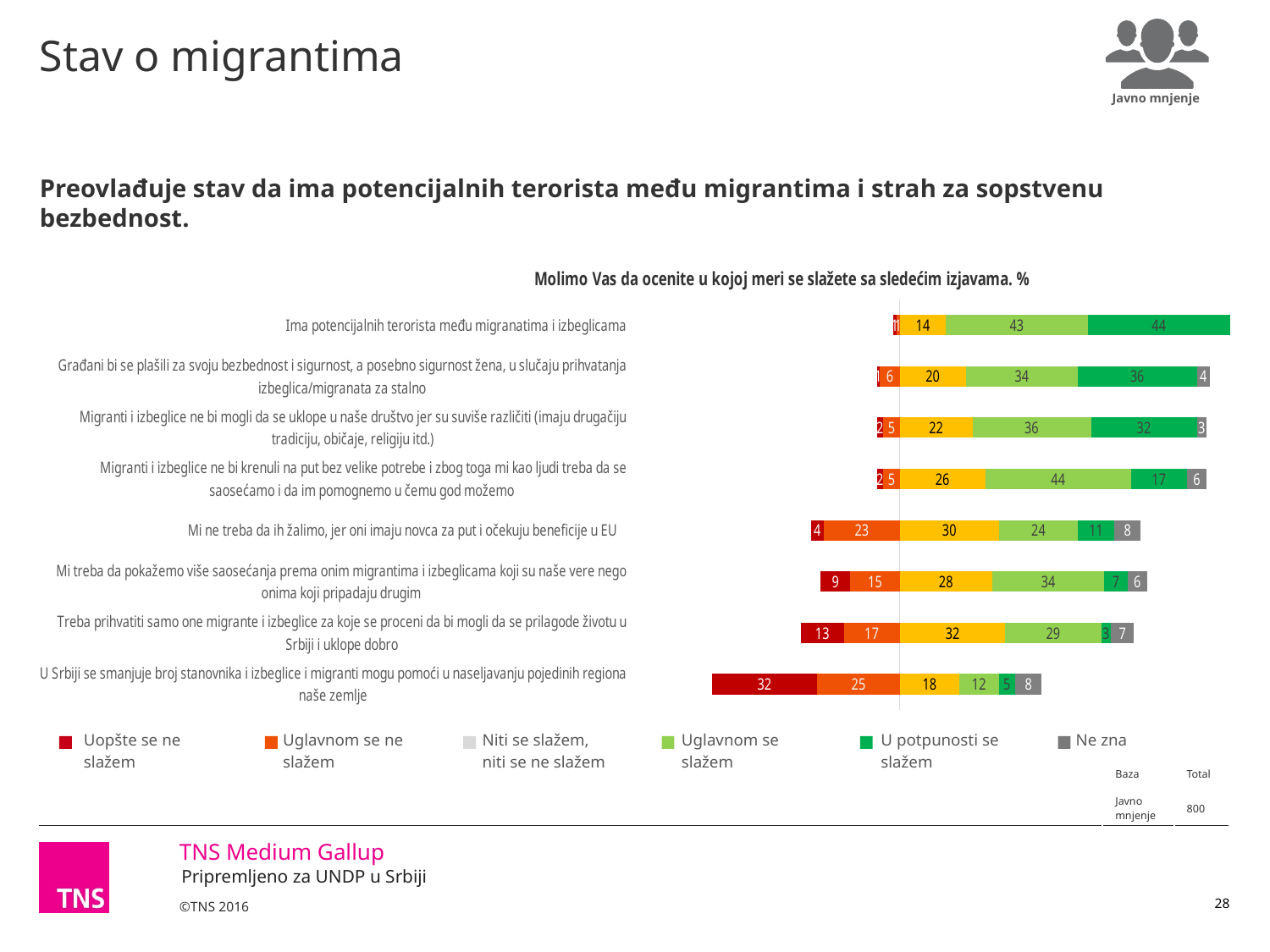
How many series does the legend list? 6 What is the difference between the "Uglavnom se slažem" and "U potpunosti se slažem" values for the statement "Mi treba da pokažemo više saosećanja prema onim migrantima i izbeglicama koji su naše vere nego onima koji pripadaju drugim"? 27 What is the value of "U potpunosti se slažem" for the statement "Ima potencijalnih terorista među migranatima i izbeglicama"? 44 For the statement "Treba prihvatiti samo one migrante i izbeglice za koje se proceni da bi mogli da se prilagode životu u Srbiji i uklope dobro", which is larger: "Niti se slažem, niti se ne slažem" or "Uglavnom se slažem"? Niti se slažem, niti se ne slažem Which statement has the lowest value for "U potpunosti se slažem"? Treba prihvatiti samo one migrante i izbeglice za koje se proceni da bi mogli da se prilagode životu u Srbiji i uklope dobro What is the base (Baza) size shown for Javno mnjenje? 800 Which statement has the highest value for "Uopšte se ne slažem"? U Srbiji se smanjuje broj stanovnika i izbeglice i migranti mogu pomoći u naseljavanju pojedinih regiona naše zemlje What kind of chart is shown on the slide? Stacked bar chart What is the value of "Uopšte se ne slažem" for the statement "U Srbiji se smanjuje broj stanovnika i izbeglice i migranti mogu pomoći u naseljavanju pojedinih regiona naše zemlje"? 32 How many statements (categories) are plotted in the chart? 8 What is the value of "Uglavnom se slažem" for the statement "Migranti i izbeglice ne bi krenuli na put bez velike potrebe i zbog toga mi kao ljudi treba da se saosećamo i da im pomognemo u čemu god možemo"? 44 What is the value of "Ne zna" for the statement "Mi ne treba da ih žalimo, jer oni imaju novca za put i očekuju beneficije u EU"? 8